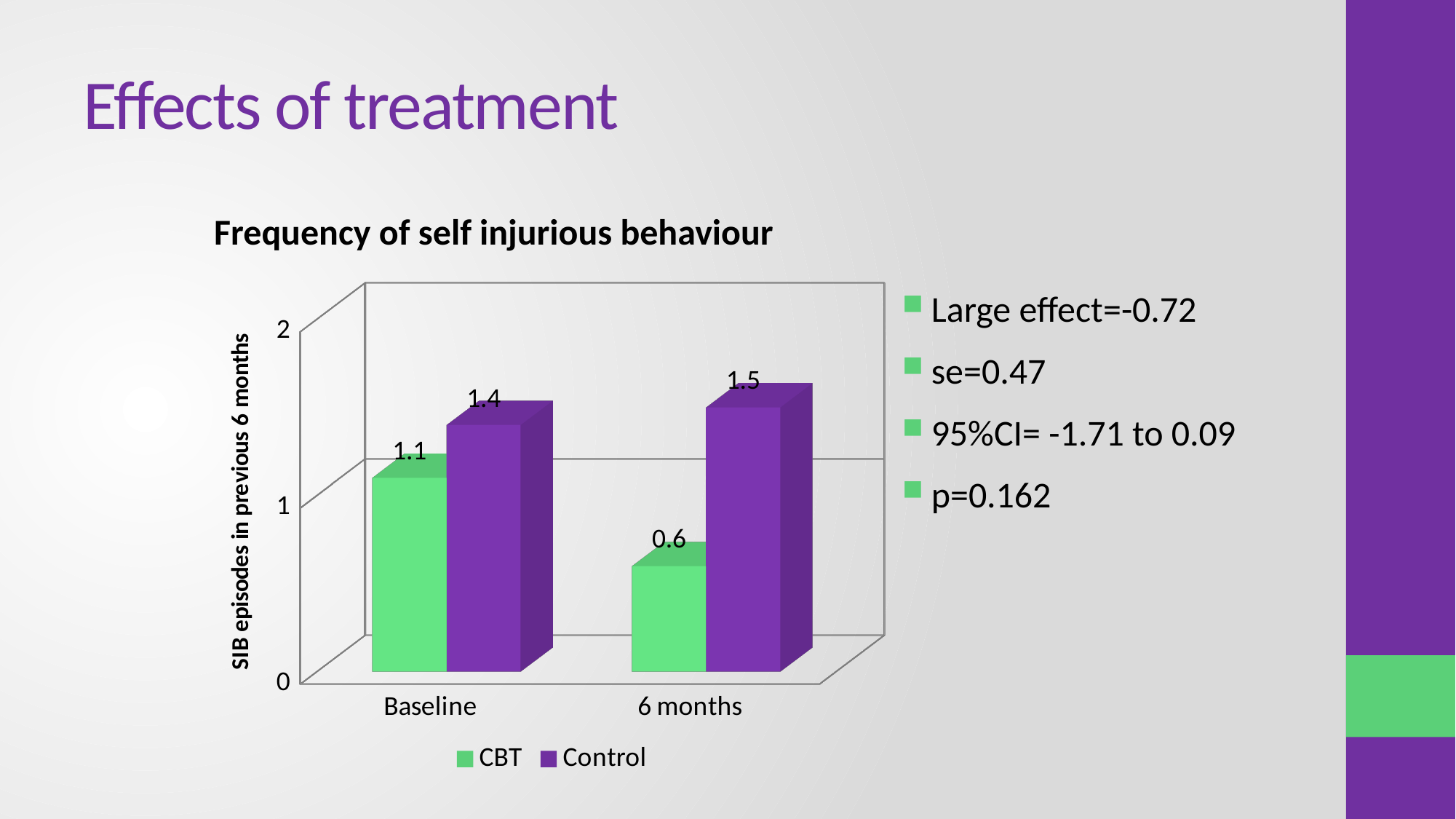
Does the CBT series rise or fall from Baseline to 6 months? Fall What is the difference between the Control and CBT values at 6 months? 0.9 How many series does the legend list? 2 What is the value for CBT at Baseline? 1.1 What is the difference between the CBT values at Baseline and 6 months? 0.5 Which is larger at Baseline, CBT or Control? Control What is the value for Control at 6 months? 1.5 How many categories are shown on the x axis? 2 What is the value for Control at Baseline? 1.4 Which series has the lowest value at 6 months? CBT What kind of chart is shown? Bar chart What is the value for CBT at 6 months? 0.6